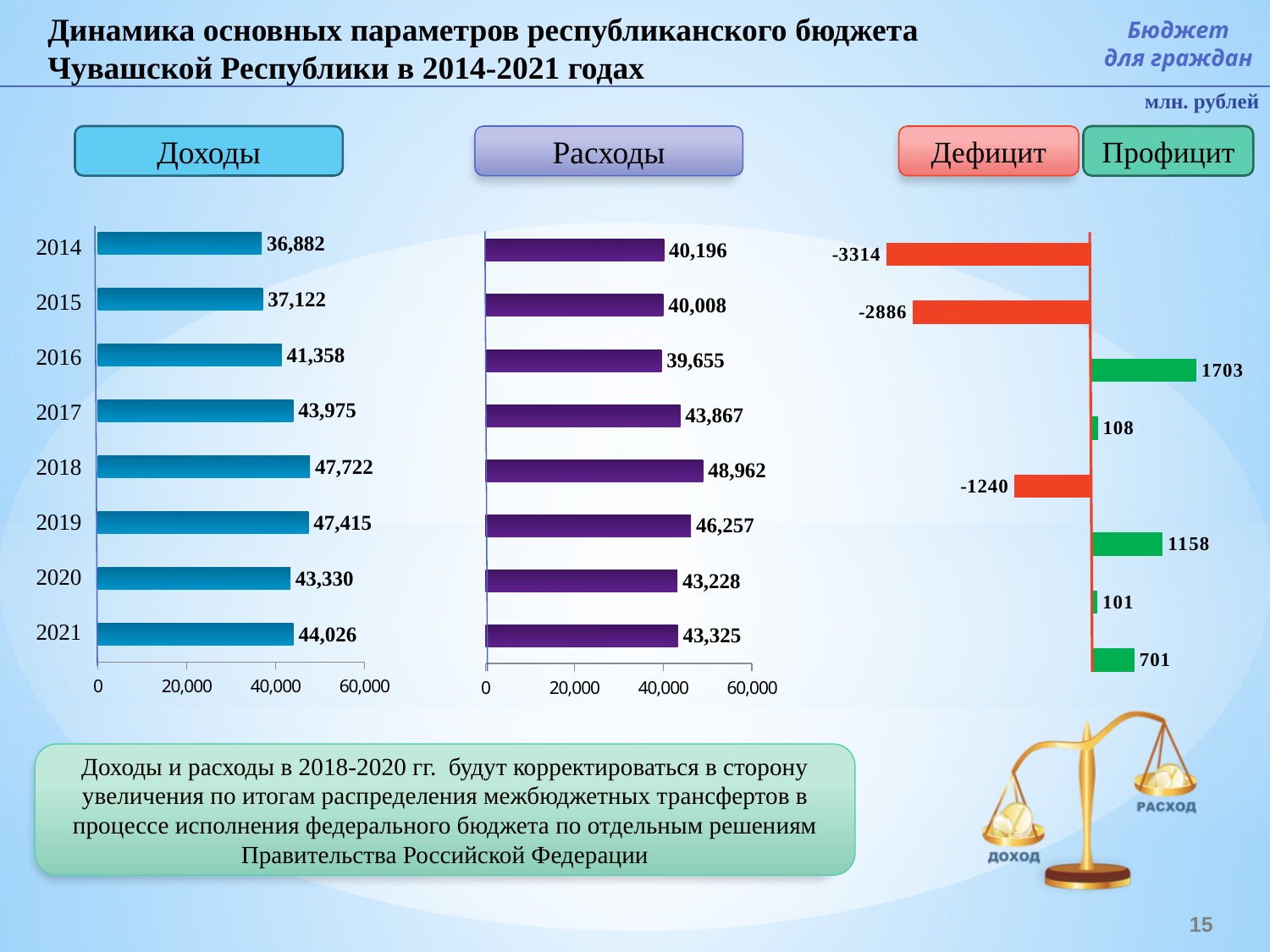
In the Расходы chart, which is larger, the value for 2019 or the value for 2020? 2019 In the Доходы chart, what is the difference between the values for 2021 and 2020? 696 In the Расходы chart, what is the value for 2016? 39,655 In the Расходы chart, which year has the highest value? 2018 How many years are shown in the Доходы chart? 8 In the Доходы chart, which year has the lowest value? 2014 In the Доходы chart, which year has the highest value? 2018 In the Дефицит/Профицит chart, what is the value for 2014? -3314 In the Дефицит/Профицит chart, which year has the largest surplus (highest positive value)? 2016 What type of chart is the Расходы chart? bar chart In the Дефицит/Профицит chart, what colour are the deficit (negative) bars? red In the Доходы chart, what is the value for 2018? 47,722